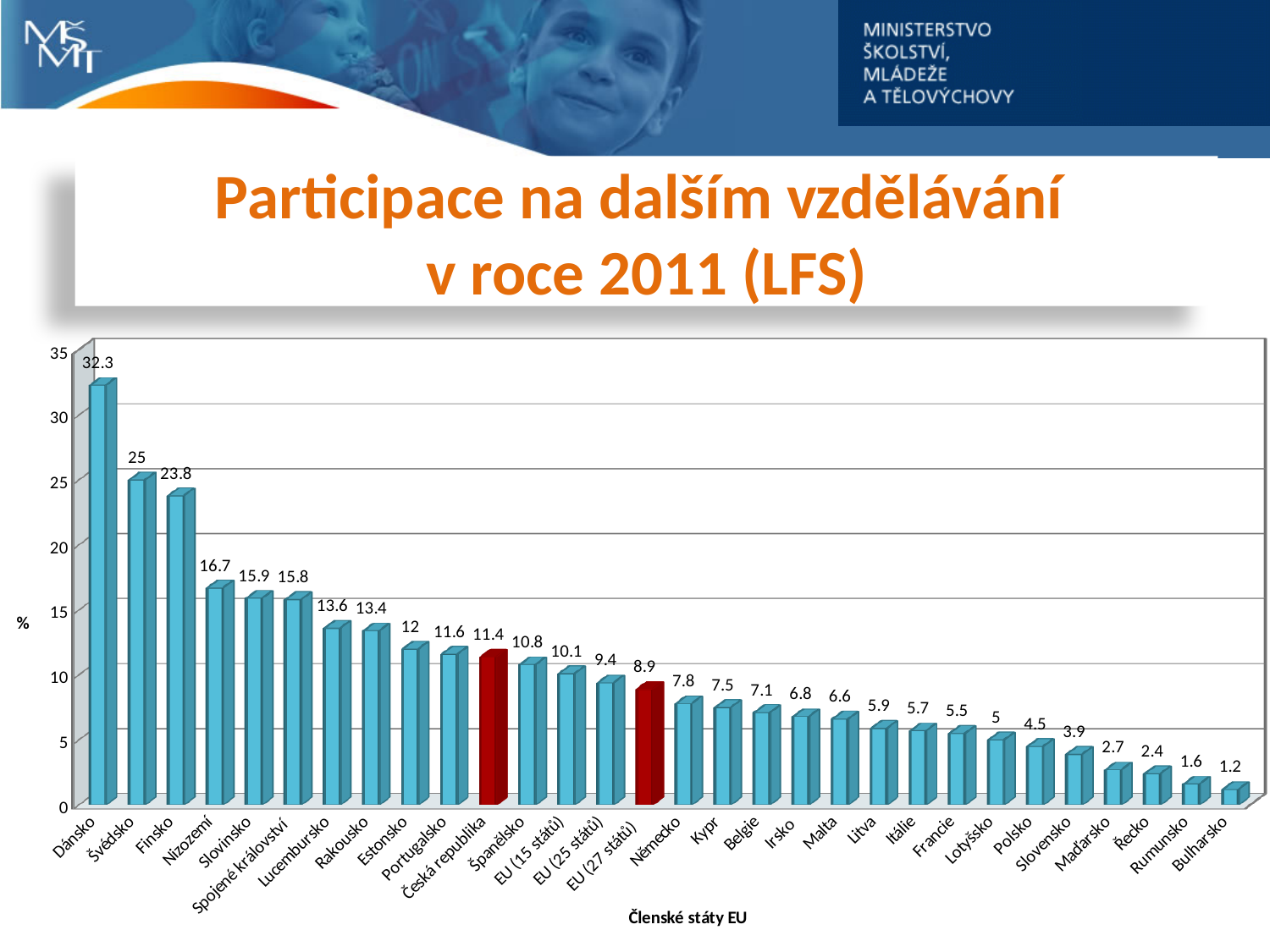
What is the value for Česká republika? 11.4 Which country has the highest value? Dánsko What is the value for Dánsko? 32.3 Which two bars are coloured dark red instead of blue? Česká republika and EU (27 států) Which has a larger value, Německo or Kypr? Německo Do the values rise or fall from left to right along the x axis? Fall What is the value for EU (27 států)? 8.9 What kind of chart is shown on the slide? Bar chart How many categories are shown on the x axis? 30 What is the difference between the values for Česká republika and EU (27 států)? 2.5 What is the difference between the values for Dánsko and Švédsko? 7.3 Which country has the lowest value? Bulharsko